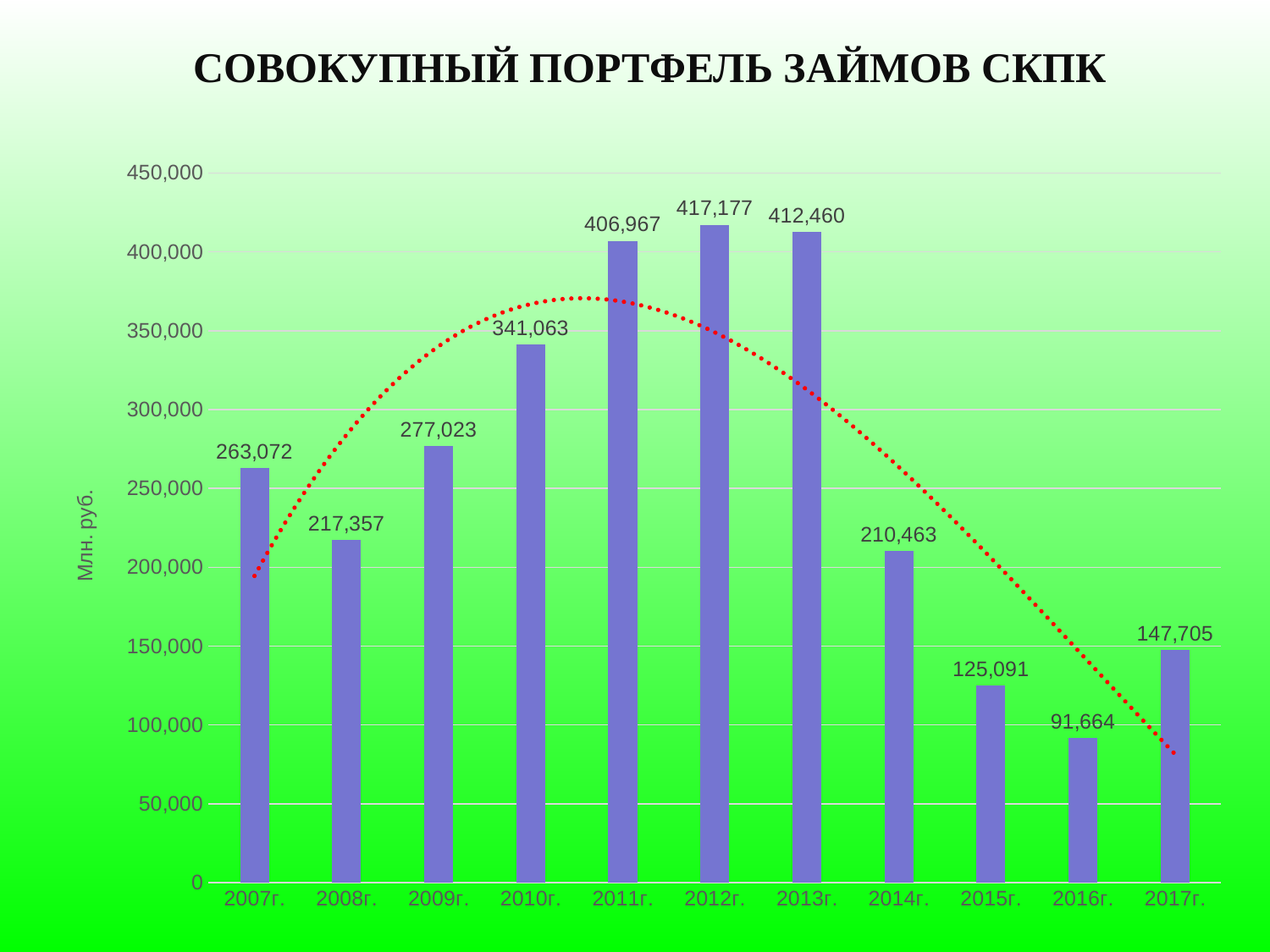
What is the difference between the values for 2007г. and 2008г.? 45,715 What is the value for 2009г.? 277,023 Which year has the lowest value? 2016г. Which is larger, the value for 2010г. or the value for 2014г.? 2010г. Is the value for 2010г. greater or less than 300,000? greater How many years are shown on the x axis? 11 What is the value for 2012г.? 417,177 What kind of chart is this? bar chart Which year has the highest value? 2012г. What is the difference between the values for 2017г. and 2016г.? 56,041 What is the title of the chart? СОВОКУПНЫЙ ПОРТФЕЛЬ ЗАЙМОВ СКПК What is the value for 2016г.? 91,664